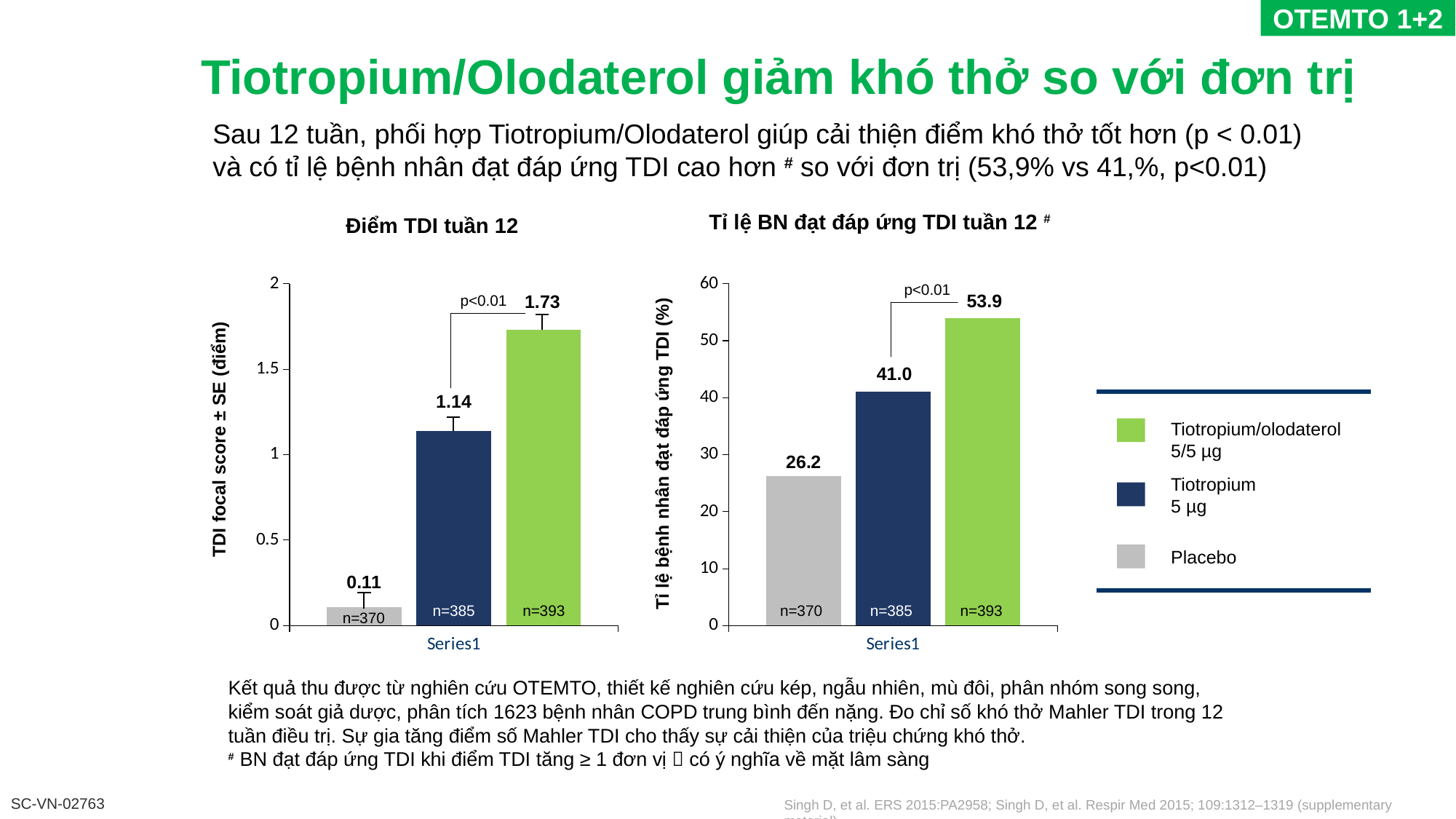
How many treatment groups does the legend on the slide list? 3 In the chart titled "Tỉ lệ BN đạt đáp ứng TDI tuần 12", which treatment group has the highest response rate? Tiotropium/olodaterol 5/5 µg In the chart titled "Tỉ lệ BN đạt đáp ứng TDI tuần 12", what is the difference in response rate between Tiotropium/olodaterol 5/5 µg and Placebo? 27.7 In the chart titled "Tỉ lệ BN đạt đáp ứng TDI tuần 12", is the response rate for Placebo greater or less than 30? less In the chart titled "Điểm TDI tuần 12", what is the TDI focal score for Placebo? 0.11 In the chart titled "Tỉ lệ BN đạt đáp ứng TDI tuần 12", what percentage of patients achieved a TDI response with Tiotropium 5 µg? 41.0 What type of chart is the chart titled "Điểm TDI tuần 12"? Bar chart In the chart titled "Điểm TDI tuần 12", which treatment group has the lowest TDI focal score? Placebo How many bars are shown in the chart titled "Tỉ lệ BN đạt đáp ứng TDI tuần 12"? 3 In the chart titled "Điểm TDI tuần 12", what is the difference in TDI focal score between Tiotropium/olodaterol 5/5 µg and Tiotropium 5 µg? 0.59 In the chart titled "Điểm TDI tuần 12", what is the TDI focal score for Tiotropium/olodaterol 5/5 µg? 1.73 In the chart titled "Điểm TDI tuần 12", which is larger: the TDI focal score for Tiotropium 5 µg or for Placebo? Tiotropium 5 µg